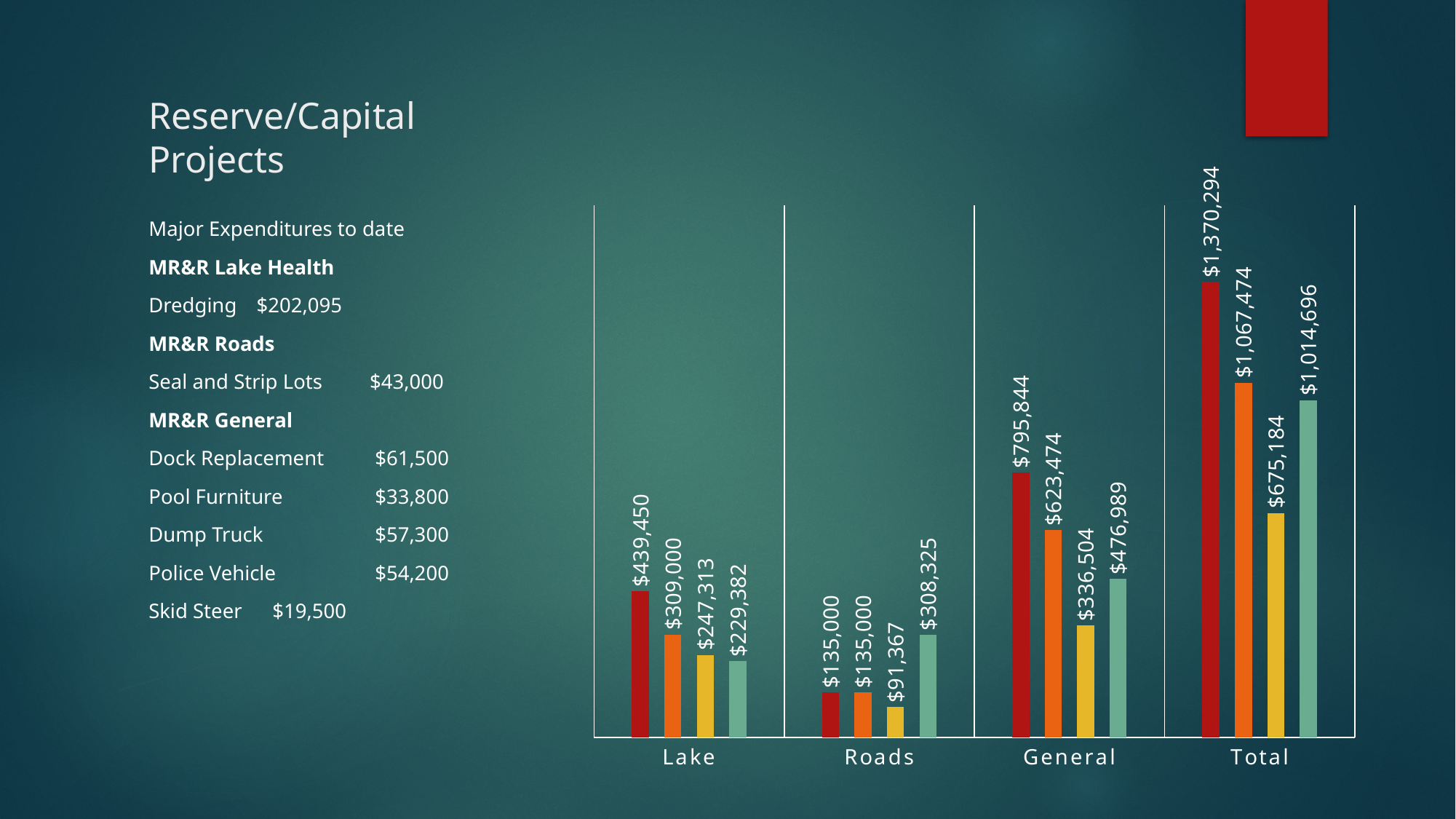
Which category has the highest red bar? Total What is the value of the red bar in the Lake category? $439,450 What is the value of the yellow bar in the Total category? $675,184 What is the difference between the red bar and the teal bar in the Lake category? $210,068 What is the difference between the red bar and the orange bar in the General category? $172,370 Which category has the lowest yellow bar? Roads Which is larger in the Roads category, the yellow bar or the teal bar? the teal bar What is the value of the orange bar in the General category? $623,474 What kind of chart is shown on the slide? bar chart How many bars are shown in each category of the chart? 4 How many categories are shown on the x axis of the chart? 4 What is the value of the teal bar in the Roads category? $308,325